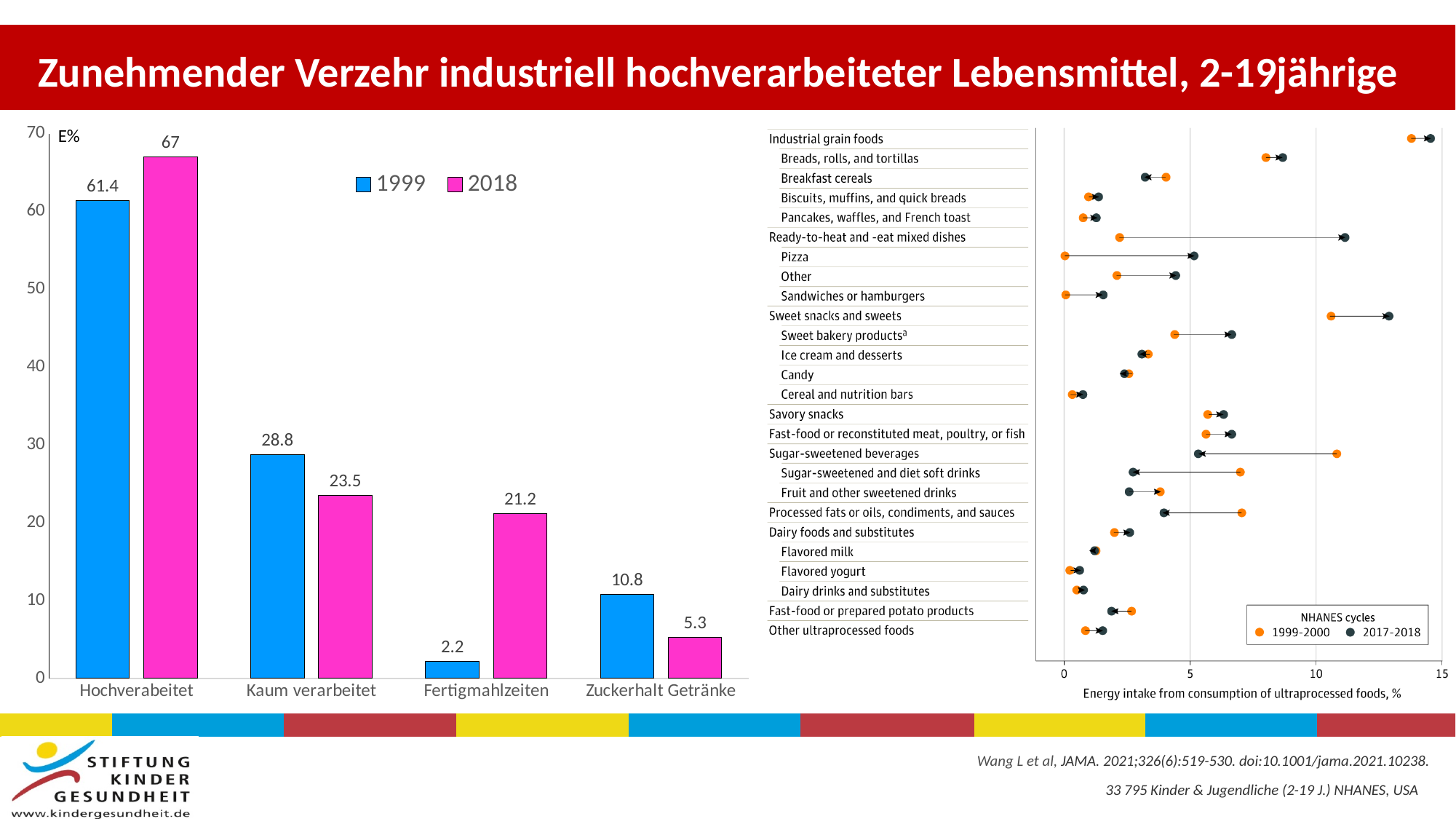
In the bar chart on the left, what is the 1999 value for Zuckerhalt Getränke? 10.8 In the bar chart on the left, which is larger for Zuckerhalt Getränke: the 1999 value or the 2018 value? 1999 What kind of chart is shown on the left of the slide? bar chart In the bar chart on the left, which category has the lowest 1999 value? Fertigmahlzeiten In the bar chart on the left, how many categories are shown on the x axis? 4 In the bar chart on the left, how many series does the legend list? 2 In the bar chart on the left, what is the 2018 value for Hochverabeitet? 67 In the bar chart on the left, which category has the highest 2018 value? Hochverabeitet In the bar chart on the left, what is the 2018 value for Fertigmahlzeiten? 21.2 In the bar chart on the left, what is the difference between the 2018 and 1999 values for Fertigmahlzeiten? 19 In the dot chart on the right, is the 2017-2018 value for Industrial grain foods greater or less than 10? greater In the bar chart on the left, what is the 1999 value for Kaum verarbeitet? 28.8